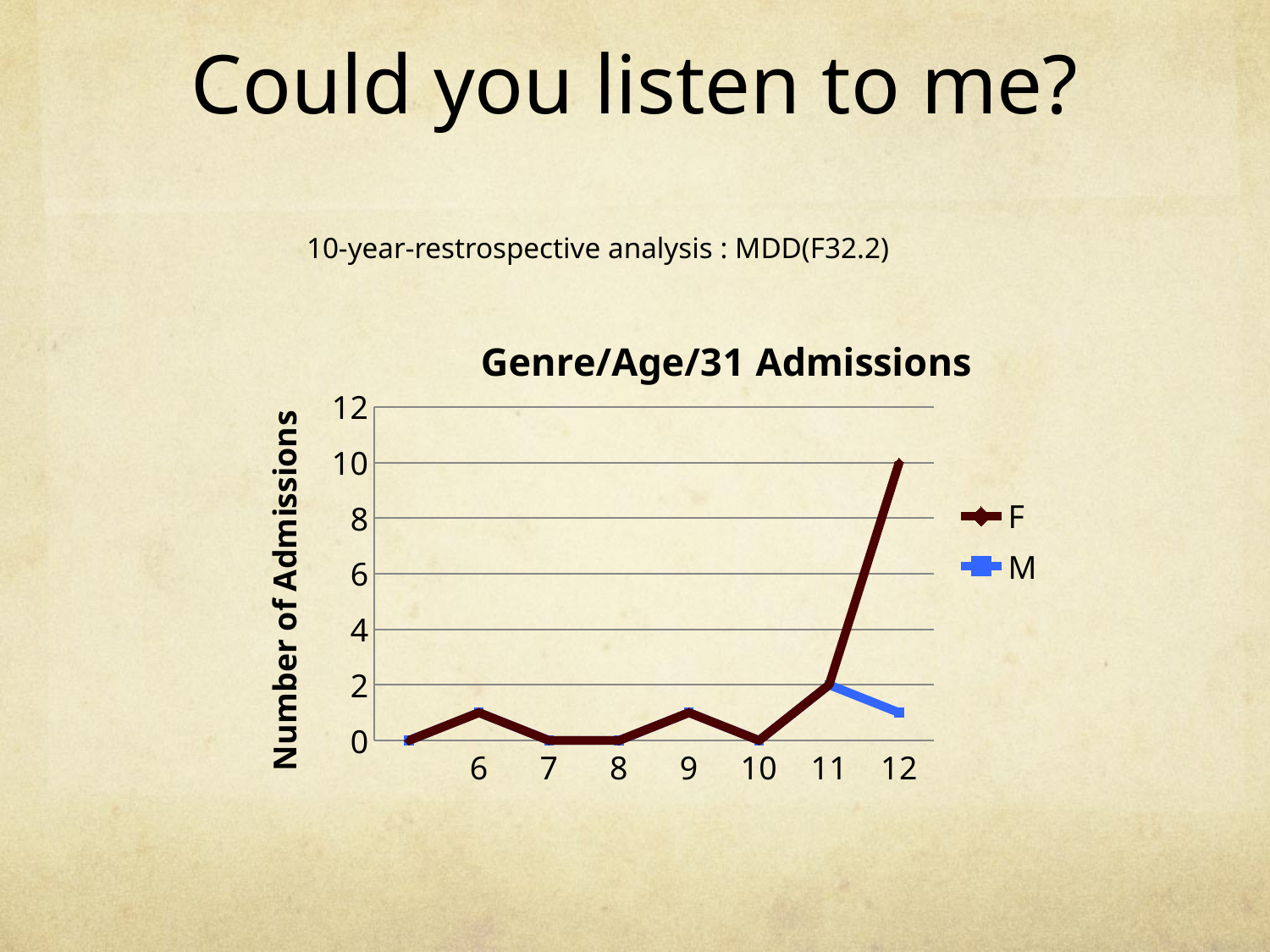
What is the value of the F series at age 7? 0 At which age does the F series reach its highest value? 12 At age 12, which series has the larger value, F or M? F What is the title of the chart? Genre/Age/31 Admissions What is the value of the F series at age 12? 10 What are the two series named in the legend? F and M What is the value of the F series at age 11? 2 Does the F series rise or fall from age 10 to age 12? rise What kind of chart is shown on the slide? line chart Is the value of the F series at age 6 greater or less than 2? less How many series does the legend list? 2 Is the value of the M series at age 12 greater or less than 2? less